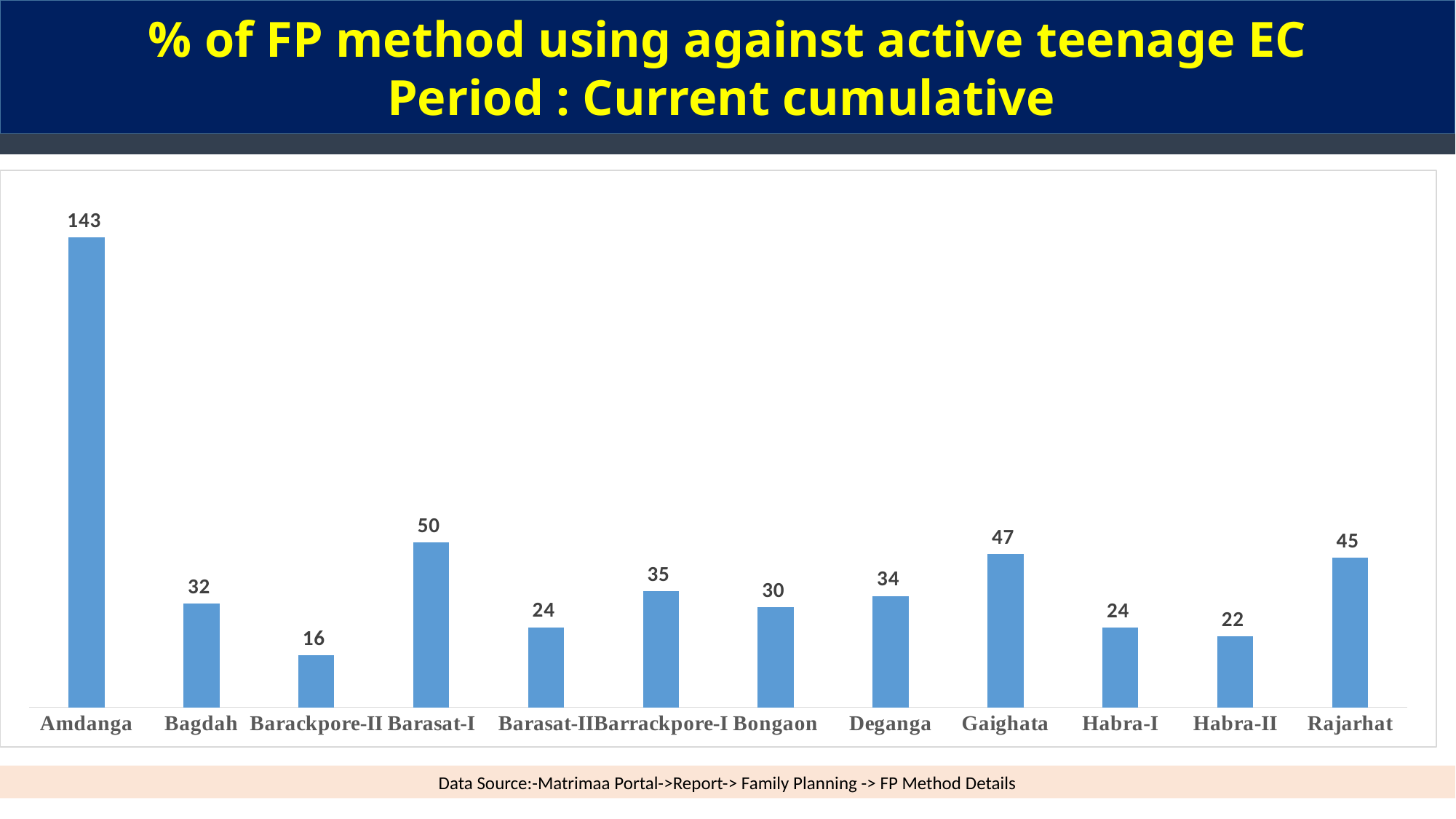
What is the difference between the values for Amdanga and Bagdah? 111 What is the value for Bongaon? 30 Which is larger, the value for Rajarhat or the value for Deganga? Rajarhat What is the title of the chart? % of FP method using against active teenage EC Period : Current cumulative What is the value for Gaighata? 47 What is the value for Amdanga? 143 What kind of chart is shown on the slide? Bar chart What is the difference between the values for Barasat-I and Barasat-II? 26 What is the value for Habra-II? 22 How many categories are shown on the x axis? 12 Which category has the highest value? Amdanga Which category has the lowest value? Barackpore-II